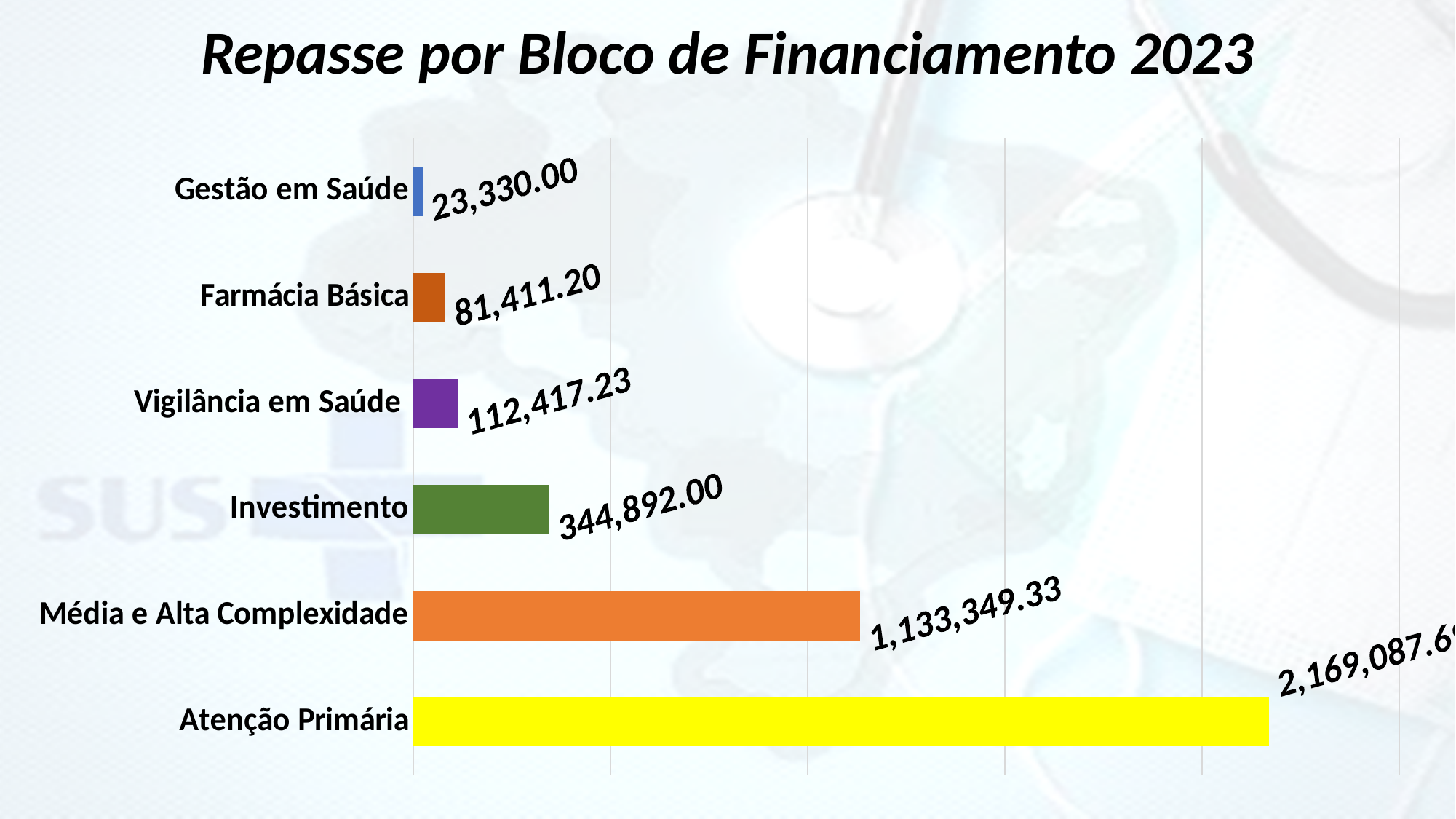
What is the value for Investimento? 344,892.00 What is the difference between the values for Farmácia Básica and Gestão em Saúde? 58,081.20 How many categories are shown in the chart? 6 Which category has the lowest value? Gestão em Saúde What is the value for Vigilância em Saúde? 112,417.23 What is the value for Farmácia Básica? 81,411.20 What is the value for Média e Alta Complexidade? 1,133,349.33 Which category has the highest value? Atenção Primária What is the value for Gestão em Saúde? 23,330.00 Which is larger, the value for Média e Alta Complexidade or the value for Investimento? Média e Alta Complexidade What kind of chart is shown on the slide? Bar chart What is the difference between the values for Investimento and Vigilância em Saúde? 232,474.77